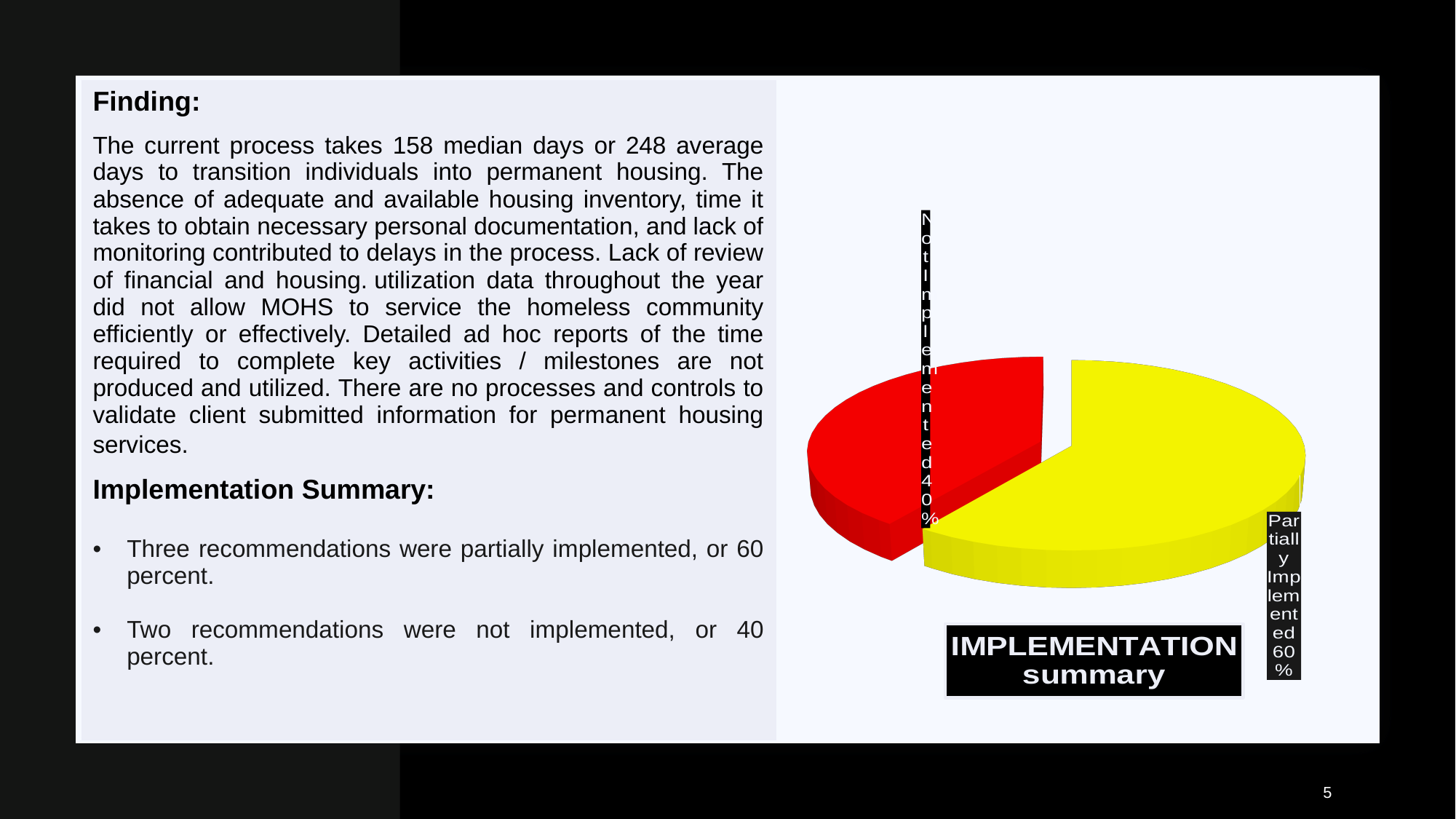
What is the title of the chart? IMPLEMENTATION summary What is the difference in percentage points between the Partially Implemented and Not Implemented slices? 20 Which slice of the pie is the largest? Partially Implemented How many slices does the pie chart have? 2 Which is larger, the Not Implemented slice or the Partially Implemented slice? Partially Implemented What colour is the Not Implemented slice? Red What percentage of the pie is labelled Not Implemented? 40% Which slice of the pie is the smallest? Not Implemented What kind of chart is shown on the slide? Pie chart What percentage of the pie is labelled Partially Implemented? 60% Is the value for Partially Implemented greater or less than 50%? greater